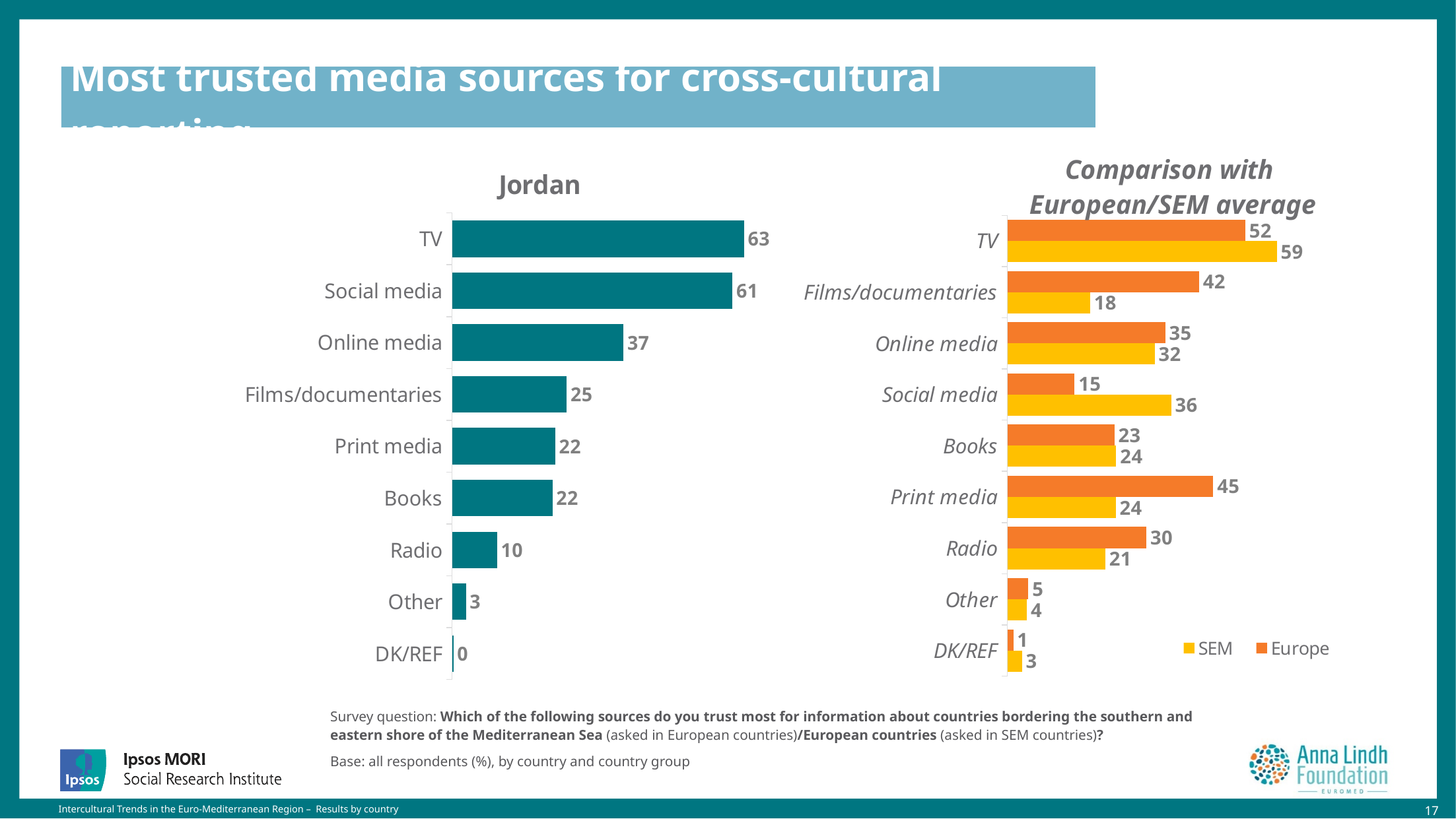
In the Comparison with European/SEM average chart, what is the difference between the Europe and SEM values for Radio? 9 In the Jordan chart, which category has the highest value? TV What type of chart is the Jordan chart? Bar chart In the Jordan chart, what is the difference between TV and Social media? 2 In the Jordan chart, what is the value for Online media? 37 In the Jordan chart, how many categories are shown? 9 How many series does the legend of the Comparison with European/SEM average chart list? 2 In the Comparison with European/SEM average chart, which is larger for Print media, SEM or Europe? Europe In the Jordan chart, which category has the lowest value? DK/REF In the Comparison with European/SEM average chart, what is the Europe value for Films/documentaries? 42 In the Comparison with European/SEM average chart, what is the SEM value for Social media? 36 In the Jordan chart, what is the value for TV? 63